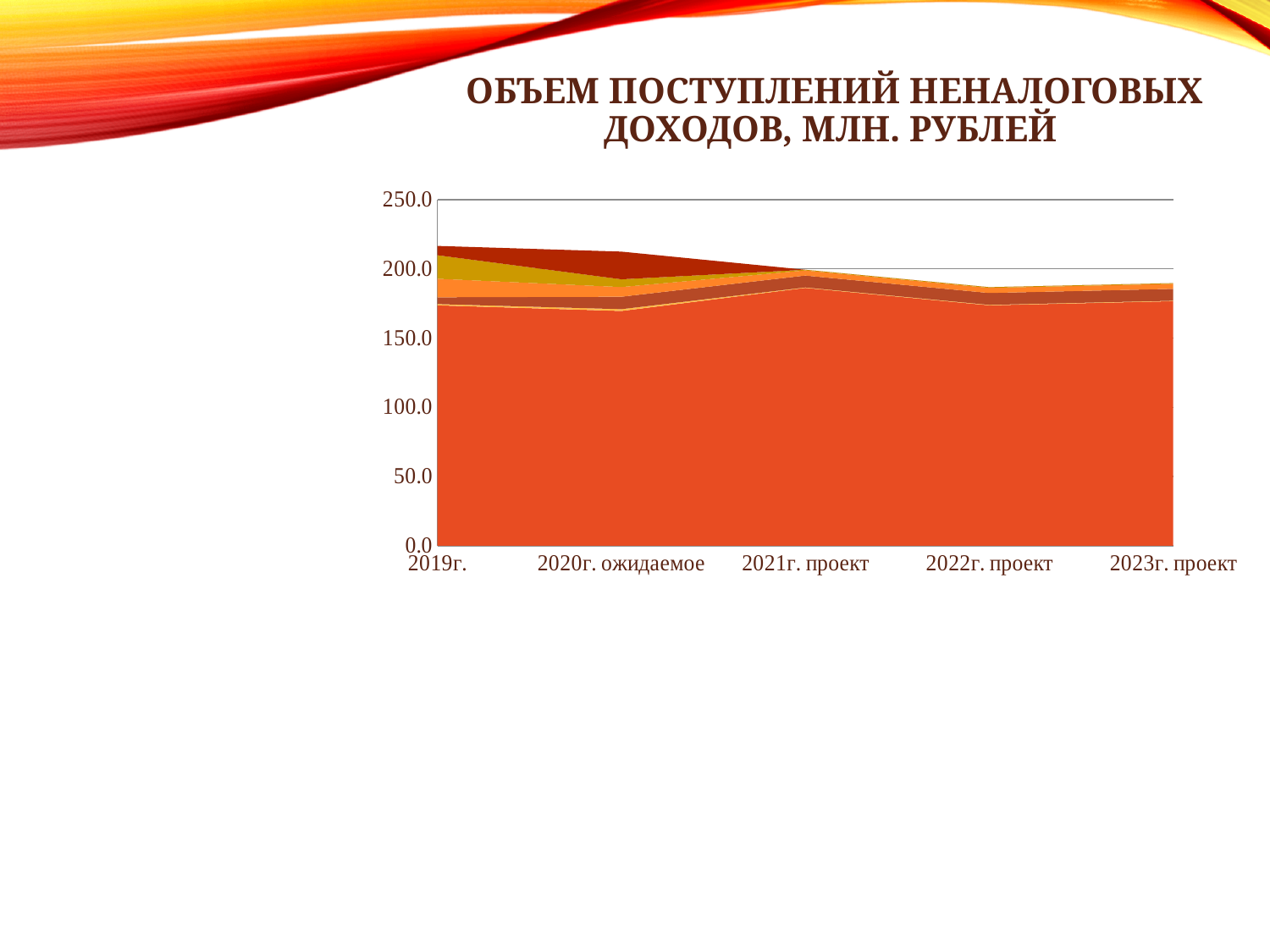
Is the total stacked value for 2023г. проект greater or less than 200.0? less What is the title of the chart? ОБЪЕМ ПОСТУПЛЕНИЙ НЕНАЛОГОВЫХ ДОХОДОВ, МЛН. РУБЛЕЙ Is the total stacked value for 2019г. greater or less than 200.0? greater Does the total stacked value rise or fall from 2019г. to 2022г. проект? fall Is the value of the bottom (largest) series for 2019г. greater or less than 150.0? greater What is the highest value shown on the y axis? 250.0 How many categories are shown along the x axis? 5 Which category has the highest total stacked value? 2019г. Which has the larger total stacked value, 2019г. or 2022г. проект? 2019г. What kind of chart is shown on the slide? area chart